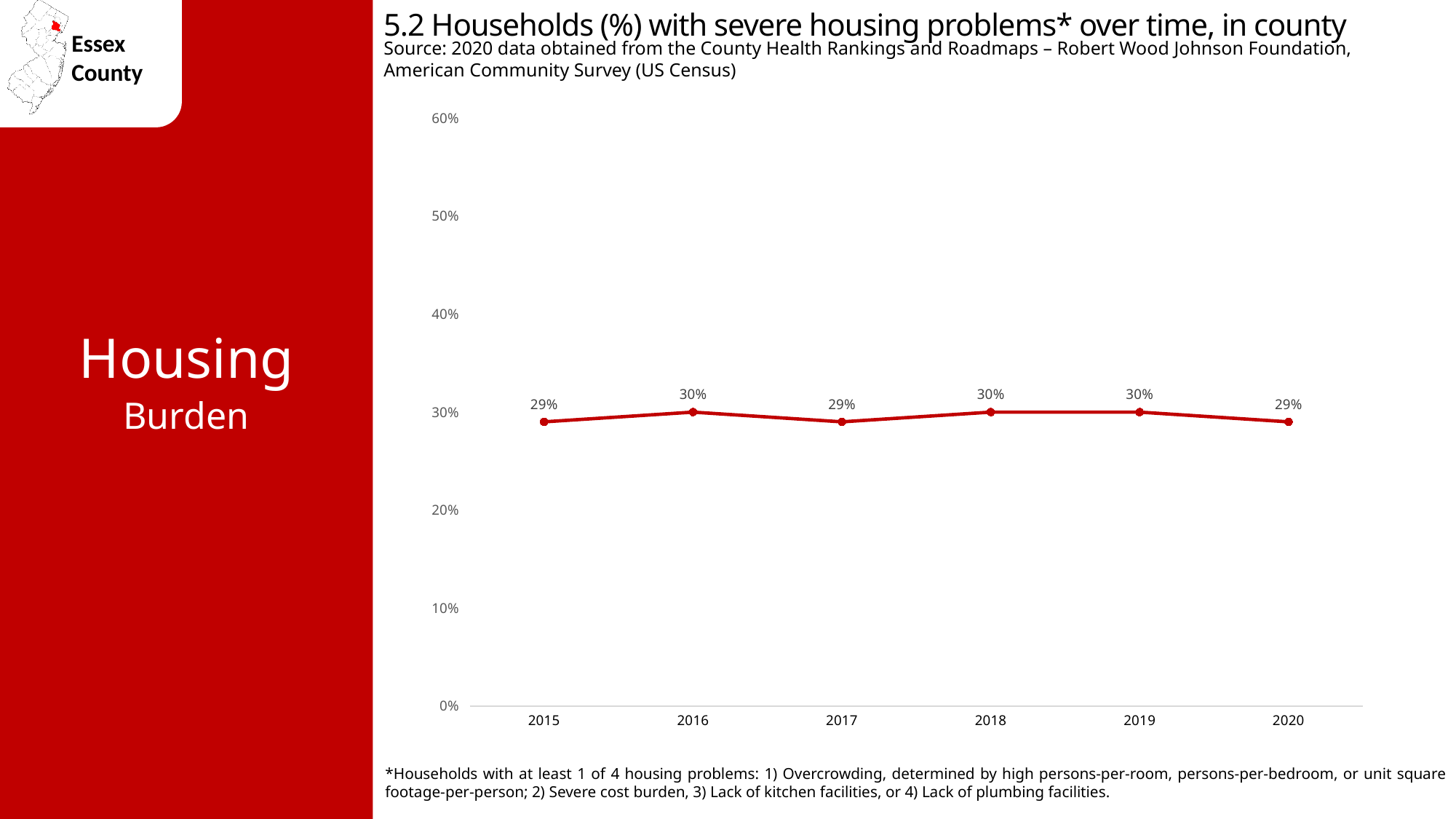
How many years are plotted on the chart? 6 Is the value for 2018 greater or less than 20%? greater Is the value for 2017 greater or less than 40%? less What is the title of the chart? 5.2 Households (%) with severe housing problems* over time, in county What percentage of households had severe housing problems in 2020? 29% What percentage of households had severe housing problems in 2015? 29% What is the value plotted for 2018? 30% What is the value plotted for 2016? 30% Which is larger, the value for 2016 or the value for 2017? 2016 What kind of chart is shown on the slide? line chart What is the difference between the values for 2019 and 2020? 1% What is the highest value shown on the y axis? 60%